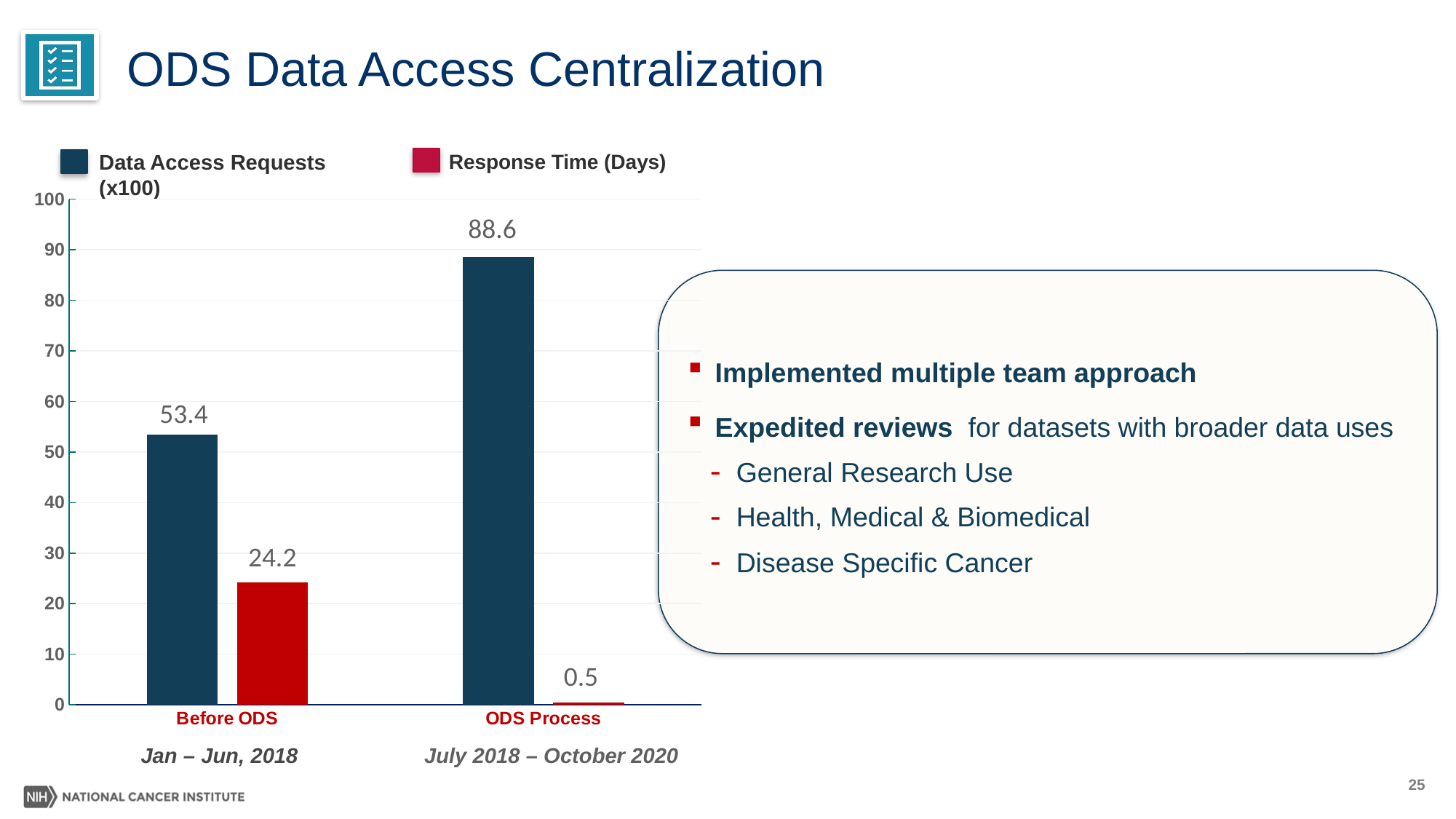
What is the value of Data Access Requests (x100) for Before ODS? 53.4 What is the difference in Data Access Requests (x100) between ODS Process and Before ODS? 35.2 What is the value of Data Access Requests (x100) for ODS Process? 88.6 What is the Response Time (Days) for ODS Process? 0.5 What is the Response Time (Days) for Before ODS? 24.2 How many series does the legend list? 2 Which category has the lowest Response Time (Days)? ODS Process Is the Response Time (Days) for Before ODS greater or less than 30? less Which category has the higher Data Access Requests (x100) value? ODS Process What is the difference in Response Time (Days) between Before ODS and ODS Process? 23.7 How many categories are shown on the x axis? 2 What kind of chart is shown on the slide? Bar chart